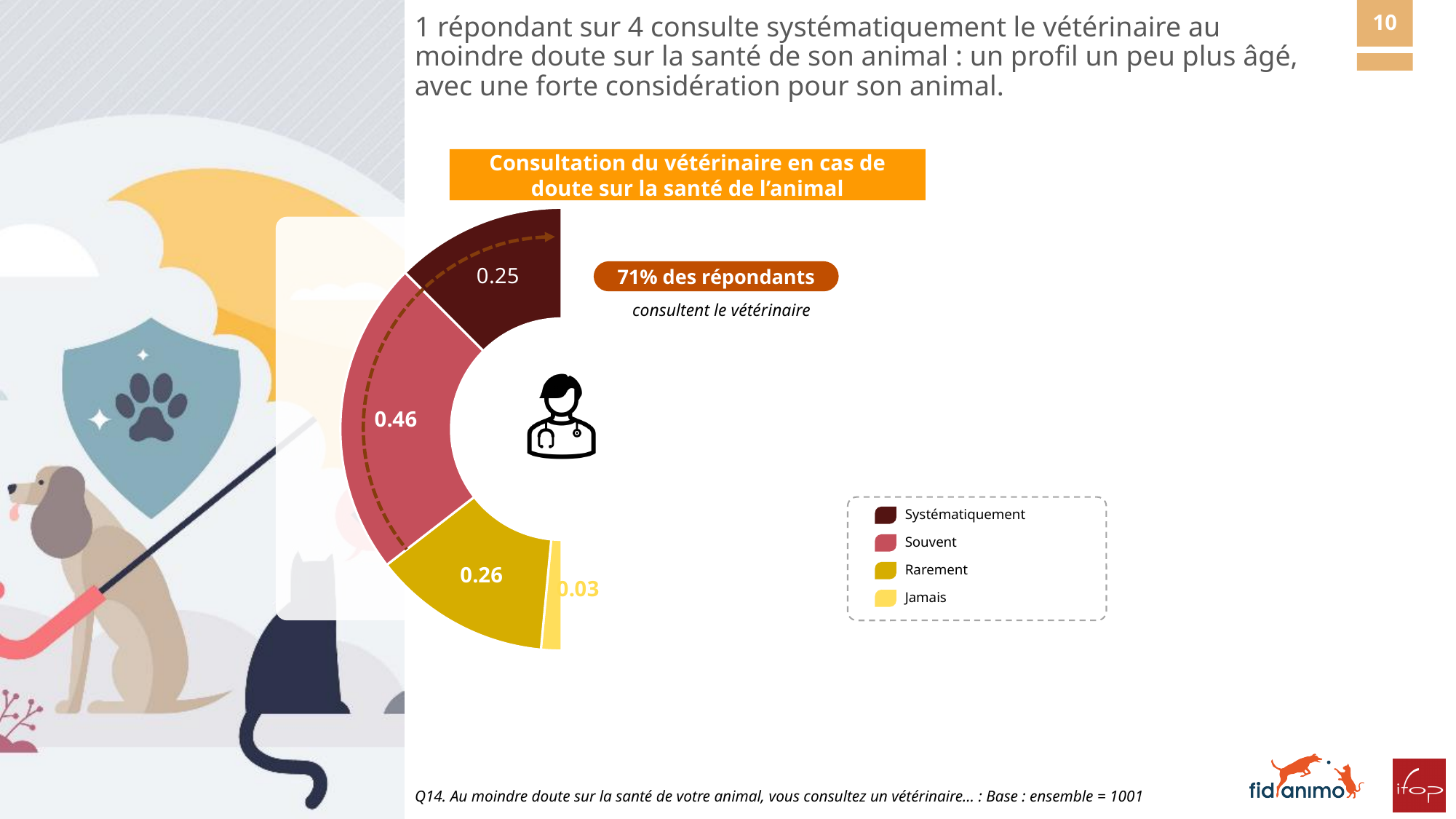
How many categories does the doughnut chart show? 4 What is the title of the chart? Consultation du vétérinaire en cas de doute sur la santé de l'animal What is the difference between the values for Souvent and Rarement? 0.20 What kind of chart is shown on the slide? Doughnut chart What is the value for Rarement in the doughnut chart? 0.26 Which category has the smallest share of the doughnut chart? Jamais What is the value for Souvent in the doughnut chart? 0.46 What is the value for Jamais in the doughnut chart? 0.03 Which is larger, the value for Souvent or the value for Rarement? Souvent What is the combined value of Systématiquement and Souvent? 0.71 What is the value for Systématiquement in the doughnut chart? 0.25 Which category has the largest share of the doughnut chart? Souvent